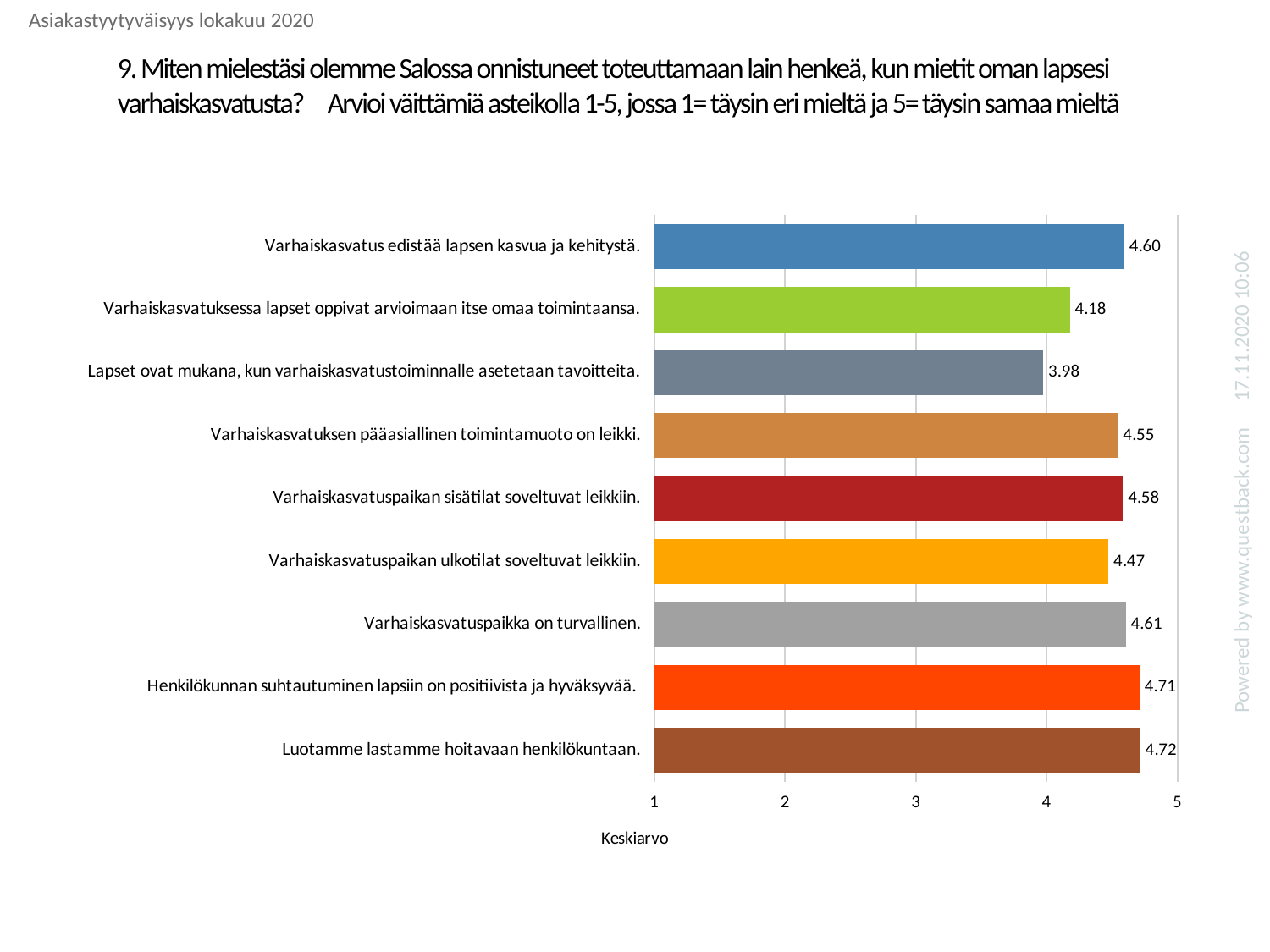
What kind of chart is shown on the slide? bar chart Is the value for "Lapset ovat mukana, kun varhaiskasvatustoiminnalle asetetaan tavoitteita." greater or less than 4? less What is the difference between the values for "Varhaiskasvatus edistää lapsen kasvua ja kehitystä." and "Varhaiskasvatuksessa lapset oppivat arvioimaan itse omaa toimintaansa."? 0.42 What is the difference between the values for "Luotamme lastamme hoitavaan henkilökuntaan." and "Lapset ovat mukana, kun varhaiskasvatustoiminnalle asetetaan tavoitteita."? 0.74 What is the value for "Varhaiskasvatus edistää lapsen kasvua ja kehitystä."? 4.60 What is the value for "Varhaiskasvatuspaikan ulkotilat soveltuvat leikkiin."? 4.47 Which has a larger value: "Varhaiskasvatuksen pääasiallinen toimintamuoto on leikki." or "Varhaiskasvatuspaikan ulkotilat soveltuvat leikkiin."? Varhaiskasvatuksen pääasiallinen toimintamuoto on leikki. Which statement has the lowest value? Lapset ovat mukana, kun varhaiskasvatustoiminnalle asetetaan tavoitteita. How many statements are shown in the chart? 9 Which statement has the highest value? Luotamme lastamme hoitavaan henkilökuntaan. What is the label of the horizontal axis? Keskiarvo What is the value for "Lapset ovat mukana, kun varhaiskasvatustoiminnalle asetetaan tavoitteita."? 3.98